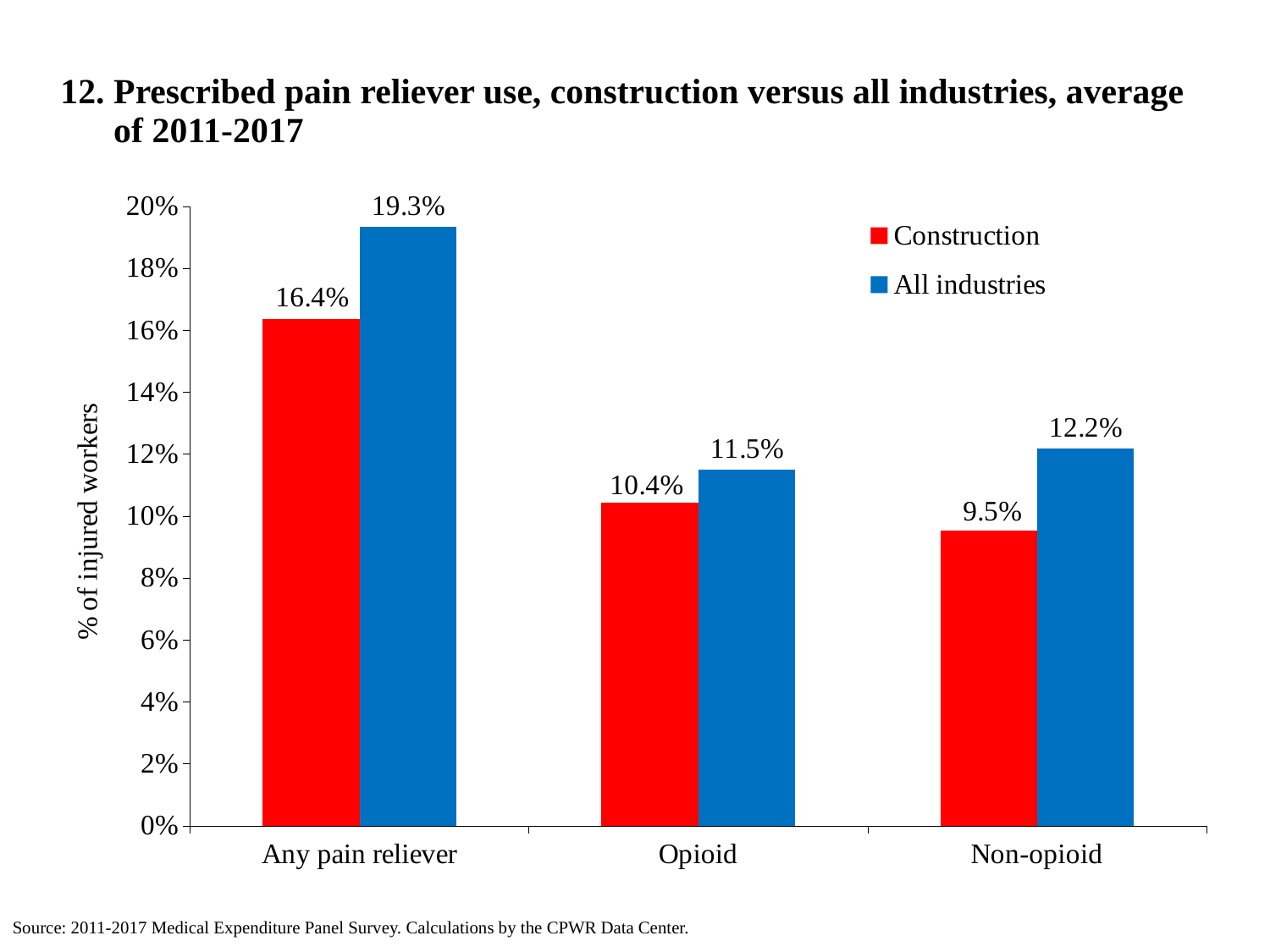
What is the label of the y axis? % of injured workers How many series does the legend list? 2 Which is larger in the Opioid category, Construction or All industries? All industries What is the value for Construction in the Any pain reliever category? 16.4% What is the difference between All industries and Construction in the Non-opioid category? 2.7% Which category has the highest value for All industries? Any pain reliever How many categories are shown on the x axis? 3 Which category has the lowest value for Construction? Non-opioid What is the value for Construction in the Non-opioid category? 9.5% What is the difference between All industries and Construction in the Any pain reliever category? 2.9% What kind of chart is shown on the slide? Bar chart What is the value for All industries in the Opioid category? 11.5%